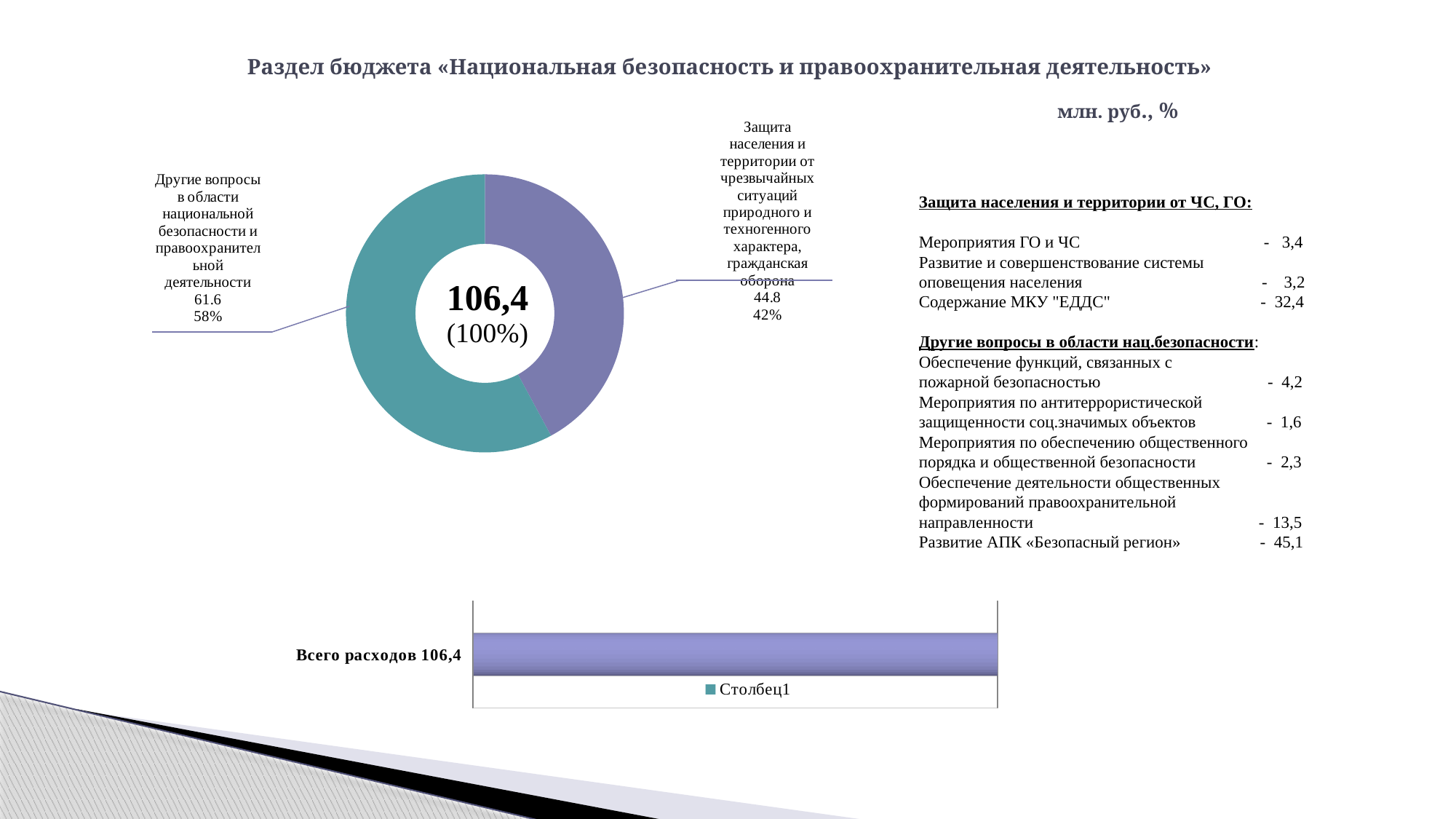
In the donut chart, what value is shown for «Другие вопросы в области национальной безопасности и правоохранительной деятельности»? 61.6 In the donut chart, what value is shown for «Защита населения и территории от чрезвычайных ситуаций природного и техногенного характера, гражданская оборона»? 44.8 In the donut chart, which category has the smaller value? Защита населения и территории от чрезвычайных ситуаций природного и техногенного характера, гражданская оборона In the bar chart at the bottom of the slide, what is the label of the single bar? Всего расходов 106,4 How many slices does the donut chart have? 2 In the donut chart, which category has the larger value? Другие вопросы в области национальной безопасности и правоохранительной деятельности In the bar chart at the bottom of the slide, what series name does the legend show? Столбец1 What total value is shown in the centre of the donut chart? 106,4 (100%) In the donut chart, what percentage share does «Другие вопросы в области национальной безопасности и правоохранительной деятельности» have? 58% What type of chart is shown on the left side of the slide? Donut (pie) chart In the donut chart, what is the difference between the values of the two categories (61.6 and 44.8)? 16.8 In the donut chart, what percentage share does «Защита населения и территории от чрезвычайных ситуаций...» have? 42%